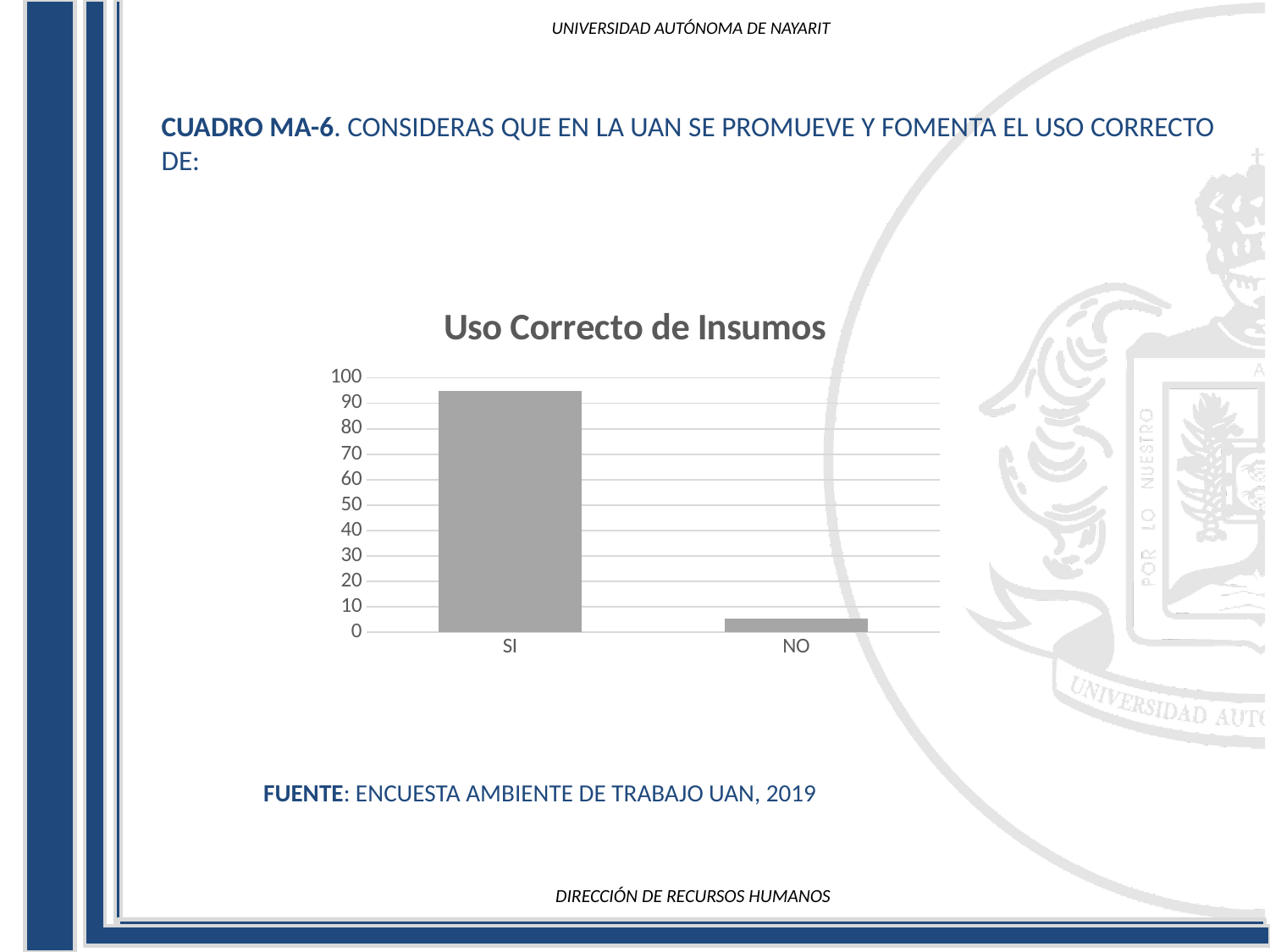
What is the highest tick value shown on the vertical axis of the chart? 100 Is the value for NO greater or less than 10? less Which category has the lowest value in the chart? NO Which category has the highest value in the chart? SI Is the value for SI greater or less than 90? greater What is the title of the chart? Uso Correcto de Insumos Which is larger, the value for SI or the value for NO? SI Is the value for SI greater or less than 100? less Do the values rise or fall from SI to NO along the x axis? fall What kind of chart is shown on the slide? bar chart How many categories are shown on the x axis of the chart? 2